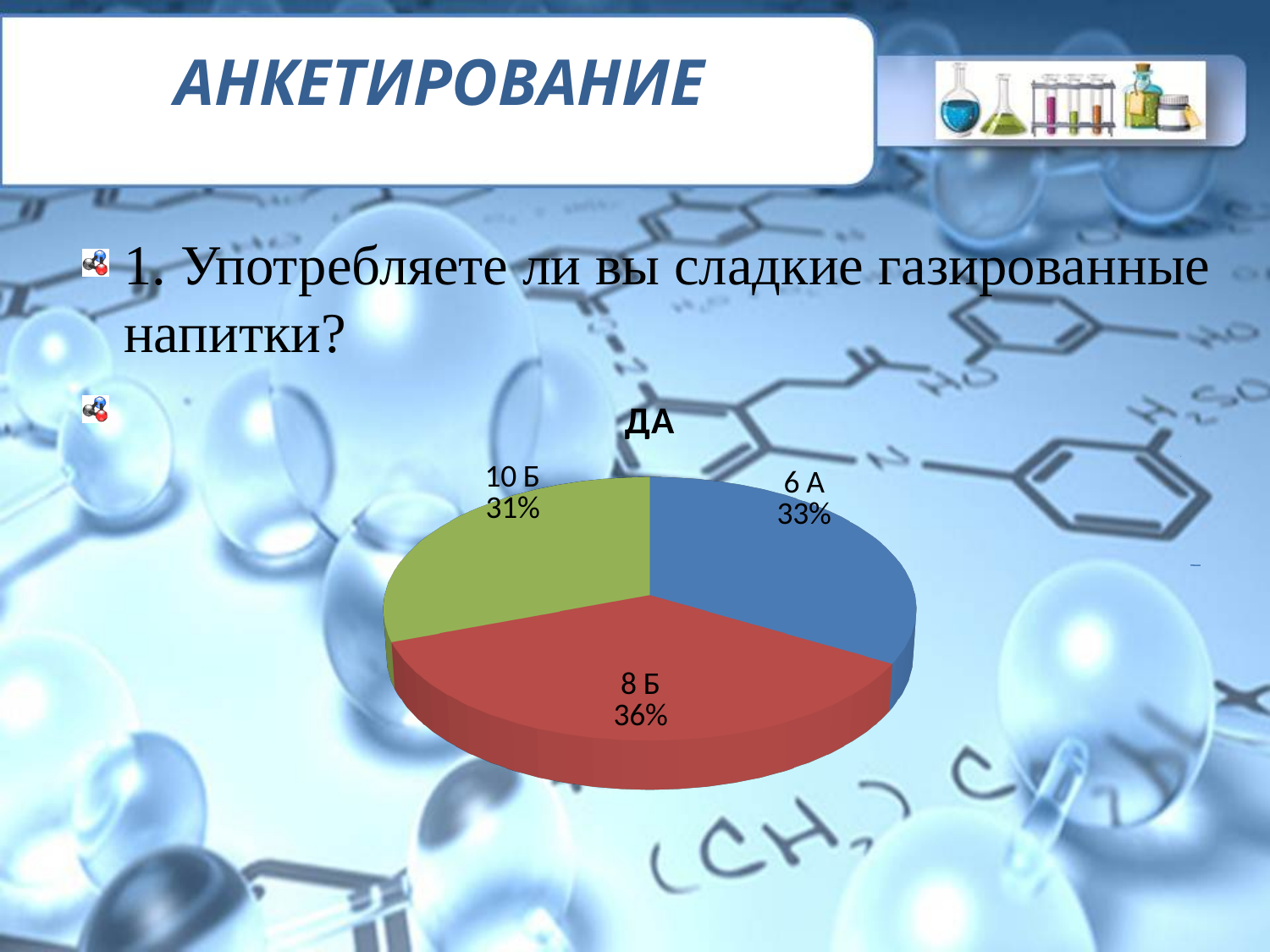
What kind of chart is shown on the slide? pie chart What is the difference in percentage points between the 8 Б slice and the 10 Б slice? 5 Which category has the largest slice of the pie? 8 Б Which slice is larger, 6 А or 8 Б? 8 Б What share of the pie does 8 Б have? 36% What is the title of the pie chart? ДА What colour is the 8 Б slice of the pie? red Which category has the smallest slice of the pie? 10 Б What share of the pie does 10 Б have? 31% How many slices does the pie chart have? 3 What is the difference in percentage points between the 6 А slice and the 10 Б slice? 2 What share of the pie does 6 А have? 33%